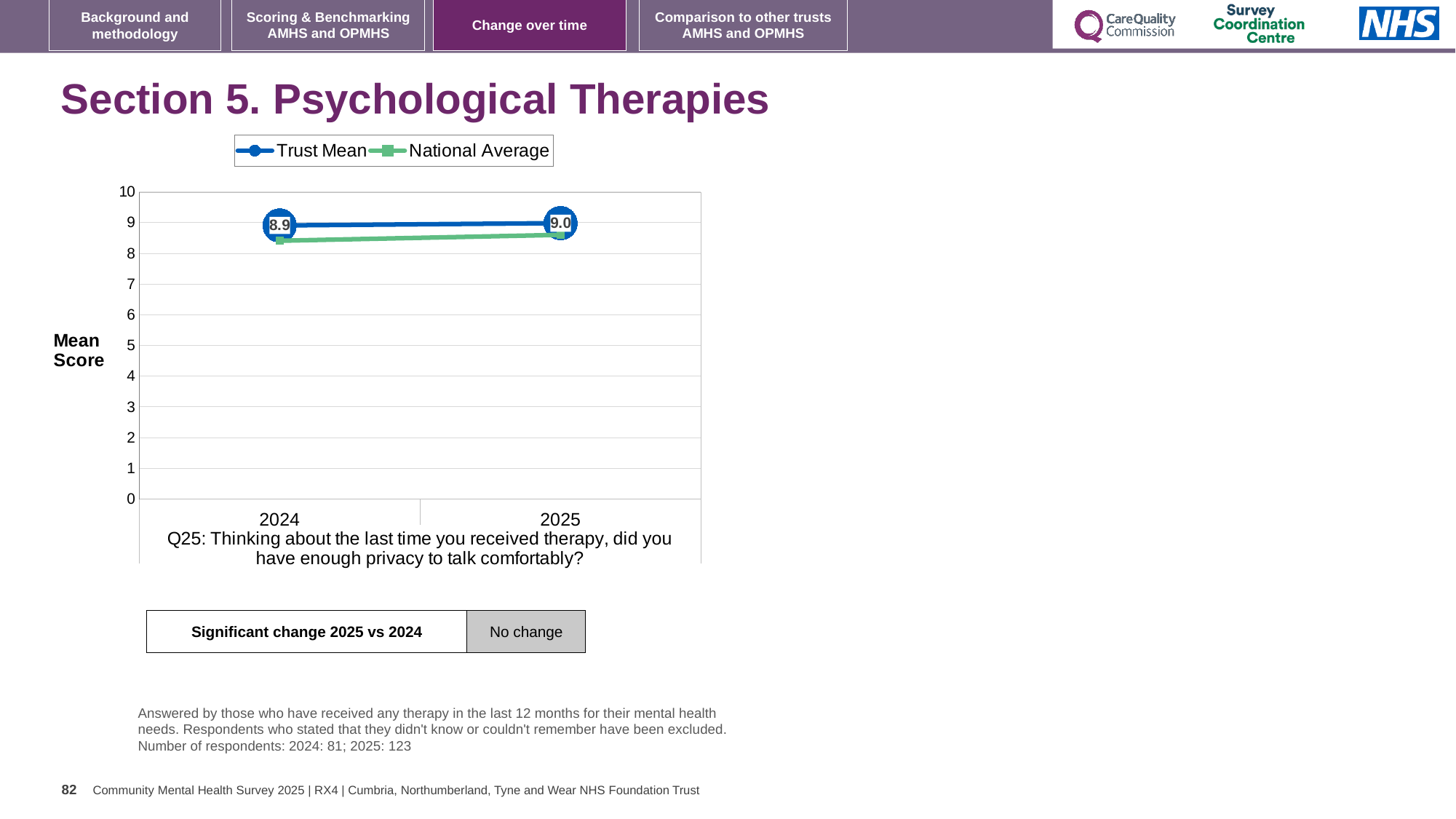
In which year is the Trust Mean higher, 2024 or 2025? 2025 What kind of chart is shown on the slide? Line chart What is the Trust Mean score for 2024? 8.9 What is the difference between the Trust Mean in 2025 and in 2024? 0.1 Is the National Average value for 2024 greater or less than 8? greater Is the National Average value for 2025 greater or less than 9? less What is the label on the y axis of the chart? Mean Score How many years are plotted on the x axis? 2 In 2024, which is higher, the Trust Mean or the National Average? Trust Mean Does the Trust Mean rise or fall from 2024 to 2025? Rise How many series does the legend list? 2 What is the Trust Mean score for 2025? 9.0